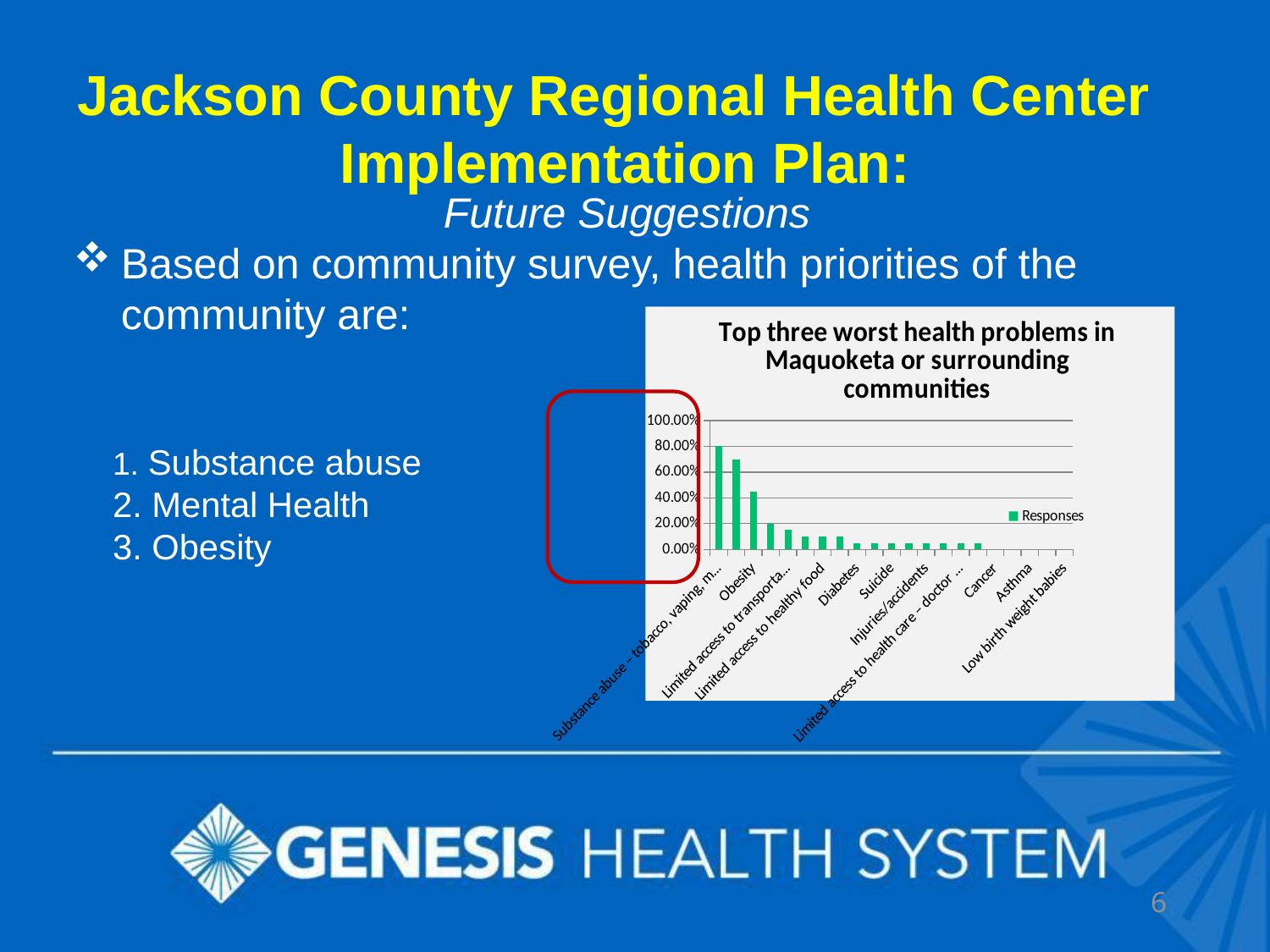
Do the bar values generally rise or fall from left to right along the x axis? fall Which has a larger value, Substance abuse or Obesity? Substance abuse Is the value for Cancer greater or less than 20.00%? less What is the title of the chart? Top three worst health problems in Maquoketa or surrounding communities Is the value for Obesity greater or less than 20.00%? greater Is the value for Low birth weight babies greater or less than 20.00%? less What type of chart is shown on the slide? bar chart How many series does the chart legend list? 1 What is the name of the series shown in the chart legend? Responses Which category has the highest value in the chart? Substance abuse – tobacco, vaping, m...